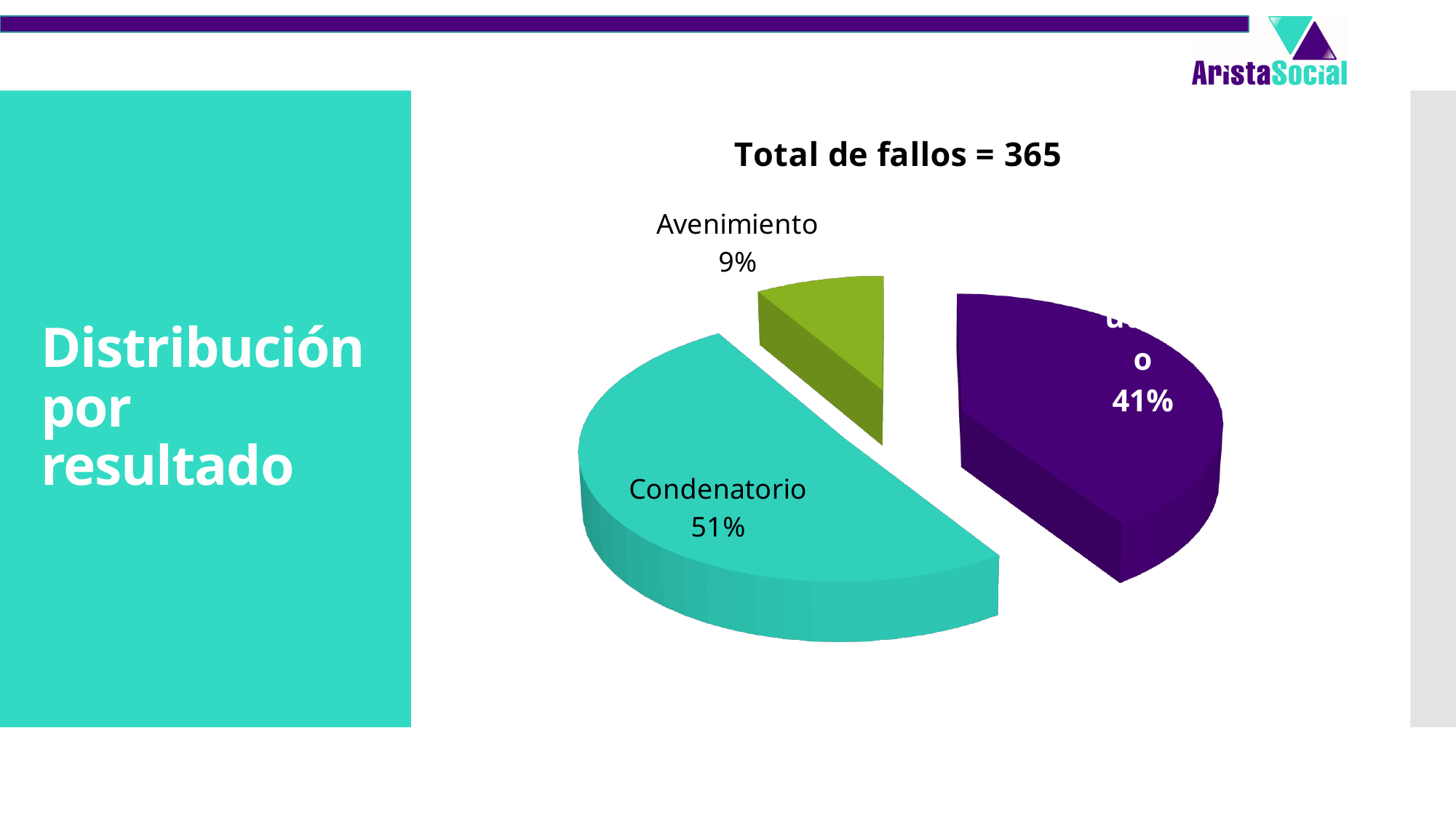
Which category has the smallest share of the pie? Avenimiento By how many percentage points does Condenatorio exceed Avenimiento? 42 percentage points Which is larger, the Condenatorio slice or the purple slice? Condenatorio What is the title of the chart? Total de fallos = 365 How many slices does the pie chart have? 3 What is the total number of fallos stated in the chart title? 365 Which is larger, the share for Condenatorio or the share for Avenimiento? Condenatorio What kind of chart is shown on the slide? Pie chart What percentage of fallos are Condenatorio? 51% Which category has the largest share of the pie? Condenatorio What percentage of fallos are Avenimiento? 9% What percentage is shown on the purple slice of the pie? 41%